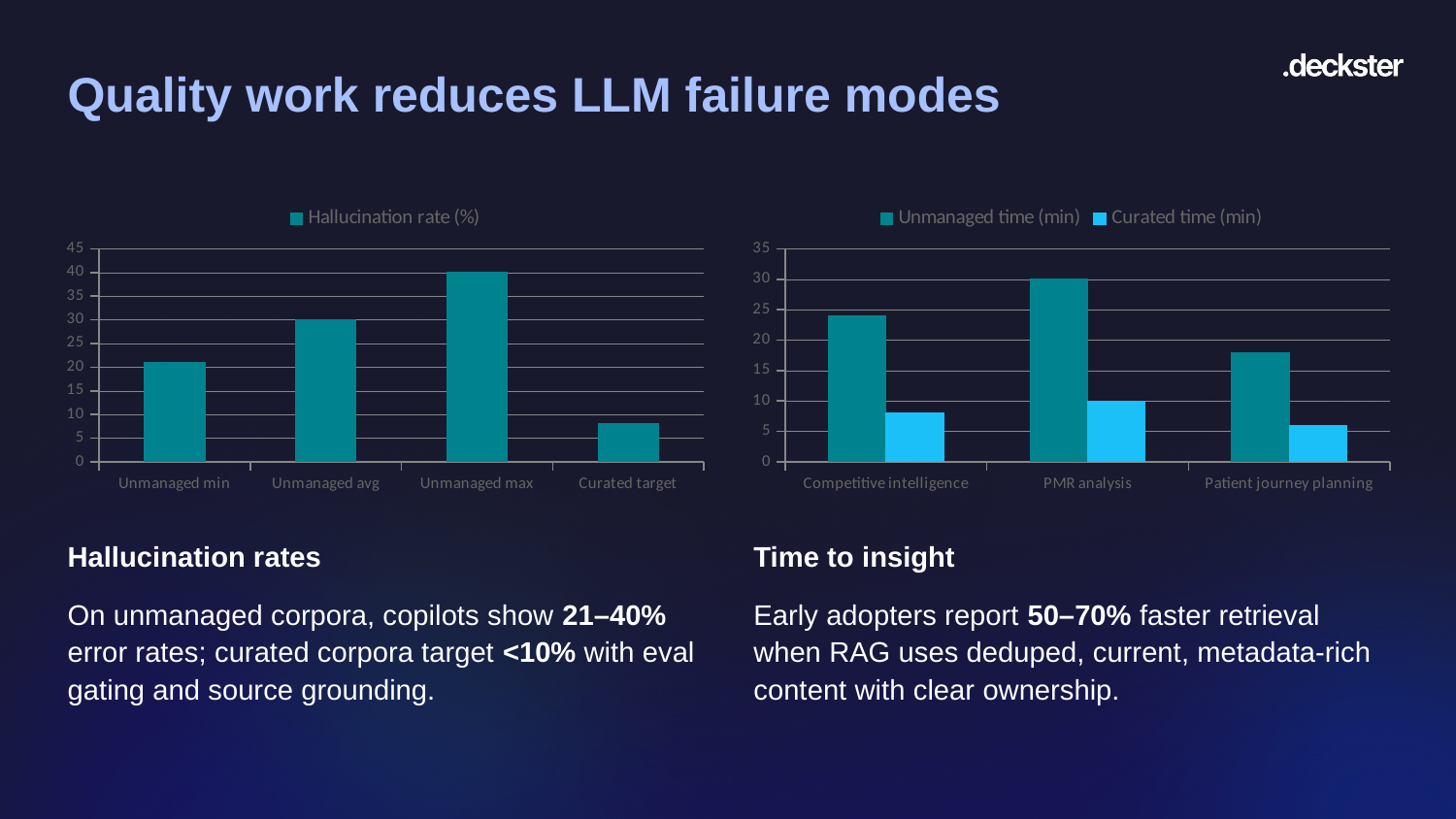
In the right chart (time to insight), how many series does the legend list? 2 In the left chart (Hallucination rate), what is the value for Unmanaged max? 40 In the left chart (Hallucination rate), how many categories are shown on the x axis? 4 What kind of chart is the right chart (time to insight)? Bar chart In the left chart (Hallucination rate), is the value for Curated target greater or less than 10? less In the right chart (time to insight), is the Unmanaged time for Competitive intelligence greater or less than 20? greater In the right chart (time to insight), what is the Unmanaged time (min) for PMR analysis? 30 In the left chart (Hallucination rate), what is the difference between Unmanaged max and Unmanaged avg? 10 In the left chart (Hallucination rate), what is the value for Unmanaged avg? 30 In the right chart (time to insight), what is the Curated time (min) for PMR analysis? 10 In the left chart (Hallucination rate), which category has the lowest value? Curated target In the left chart (Hallucination rate), which category has the highest value? Unmanaged max